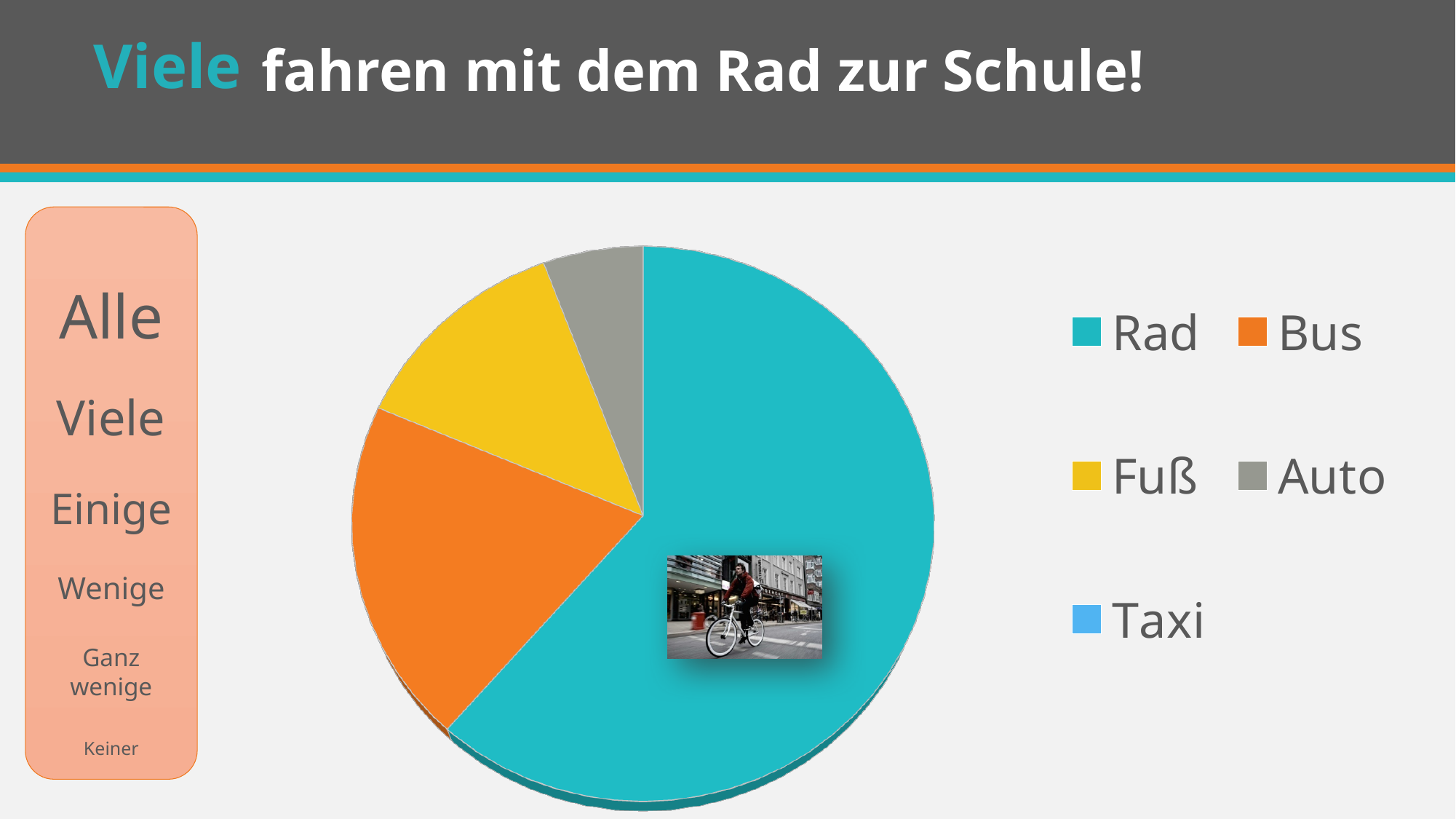
Which slice is larger, Fuß or Auto? Fuß Which legend entry has no visible slice in the pie? Taxi What colour is the Rad slice? teal Which category has the largest slice of the pie? Rad Which slice is larger, Bus or Fuß? Bus Which category has the smallest visible slice of the pie? Auto Which slice is larger, Rad or Bus? Rad How many entries does the legend list? 5 What kind of chart is shown on the slide? pie chart